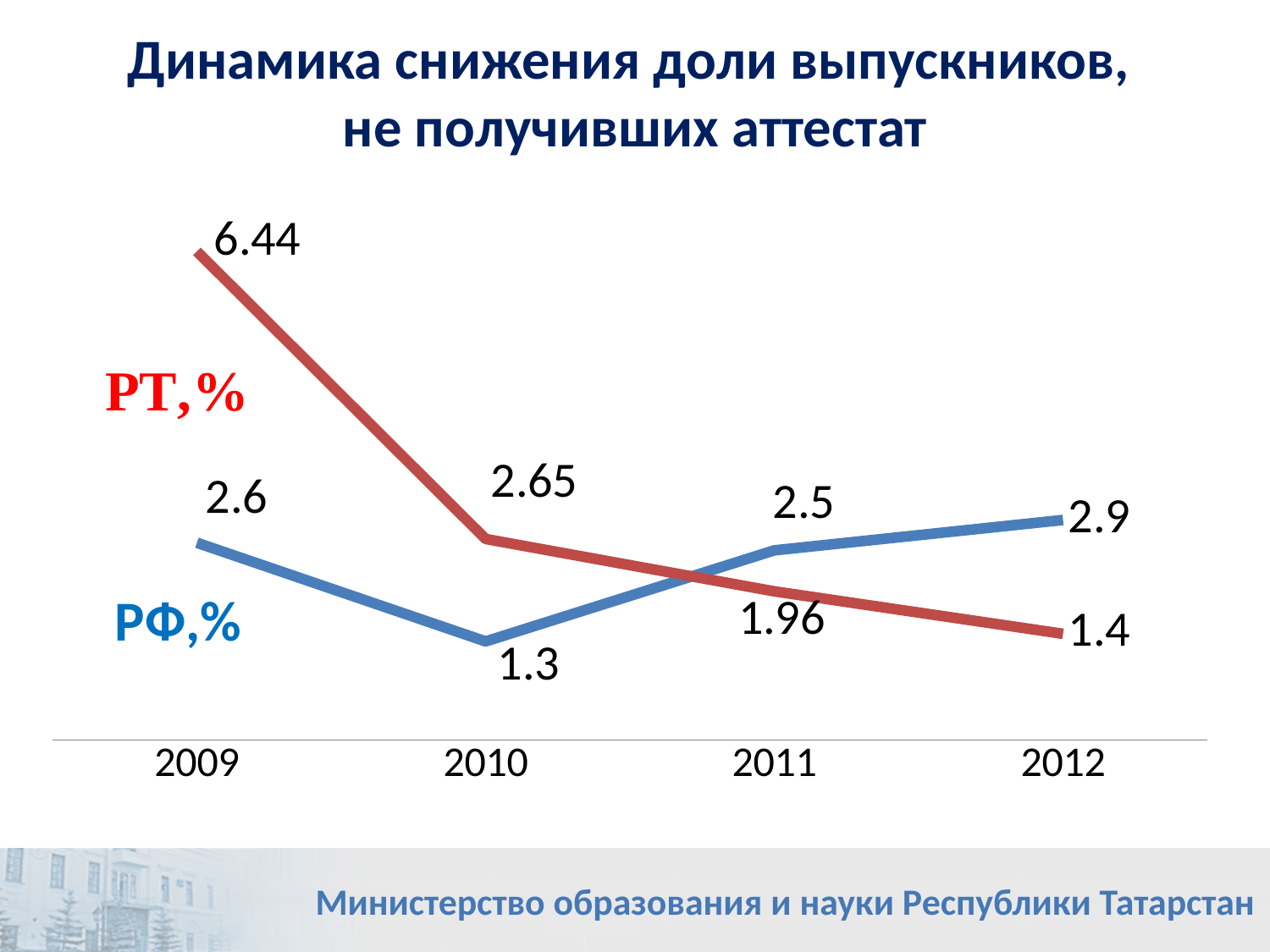
What is the value for РТ,% in 2012? 1.4 What type of chart is shown on the slide? line chart How many series are plotted on the chart? 2 How many years are shown on the x axis? 4 What is the value for РФ,% in 2010? 1.3 Which is larger in 2012: РТ,% or РФ,%? РФ,% Does the РТ,% line rise or fall from 2009 to 2012? fall What is the value for РФ,% in 2011? 2.5 What is the difference between the РТ,% values in 2009 and 2010? 3.79 What is the value for РТ,% in 2009? 6.44 In which year is the РТ,% value highest? 2009 In which year is the РФ,% value lowest? 2010